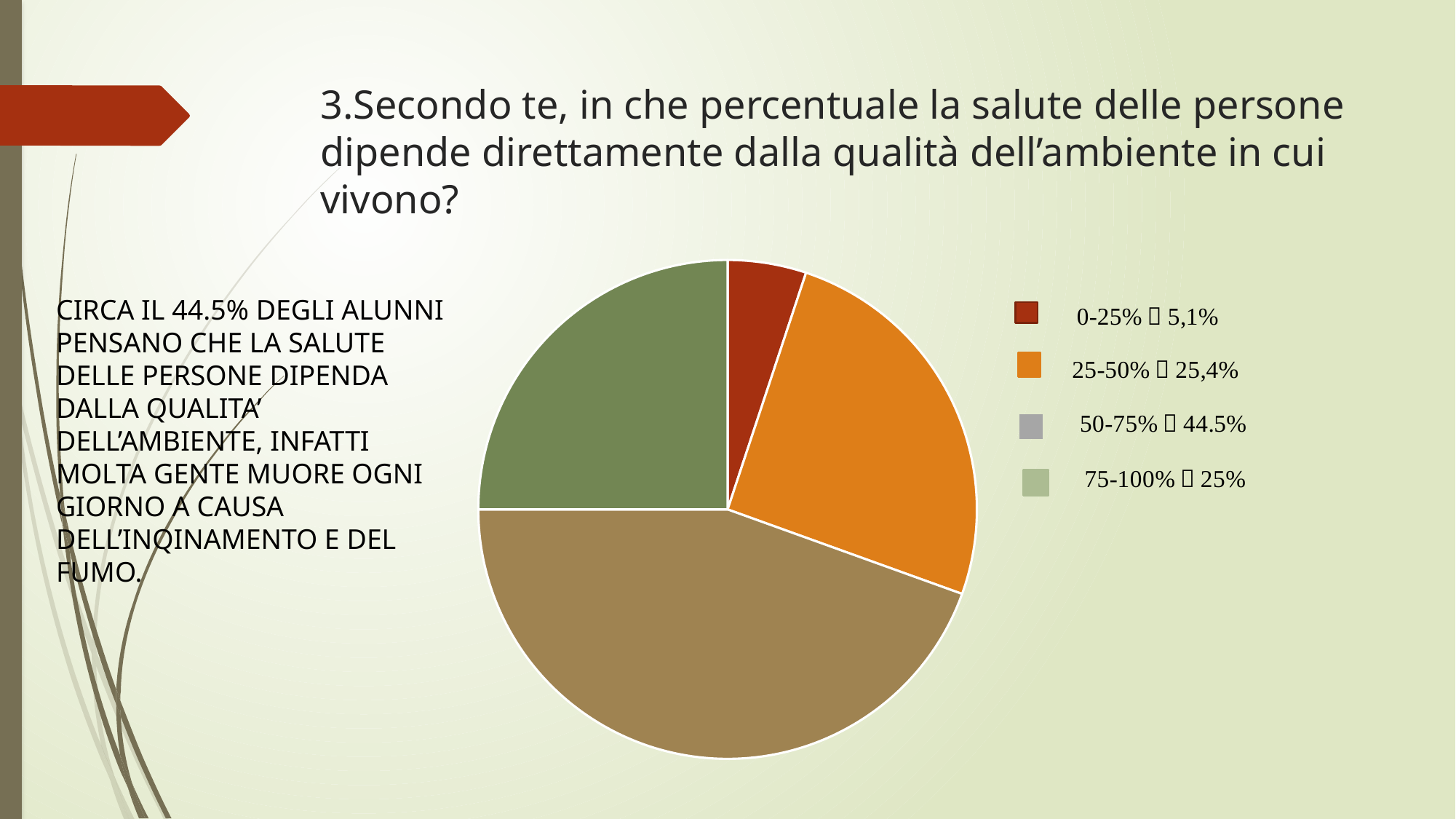
How many entries does the legend list? 4 What is the difference between the share for 50-75% and the share for 75-100%? 19.5% What percentage is shown for the 75-100% category? 25% Which category has the smallest share of the pie? 0-25% What percentage is shown for the 50-75% category? 44.5% What kind of chart is shown on the slide? pie chart What colour is the slice for the 75-100% category? green What percentage is shown for the 25-50% category? 25,4% What percentage is shown for the 0-25% category? 5,1% How many slices does the pie chart have? 4 Which is larger, the share for 25-50% or the share for 0-25%? 25-50% Which category has the largest share of the pie? 50-75%